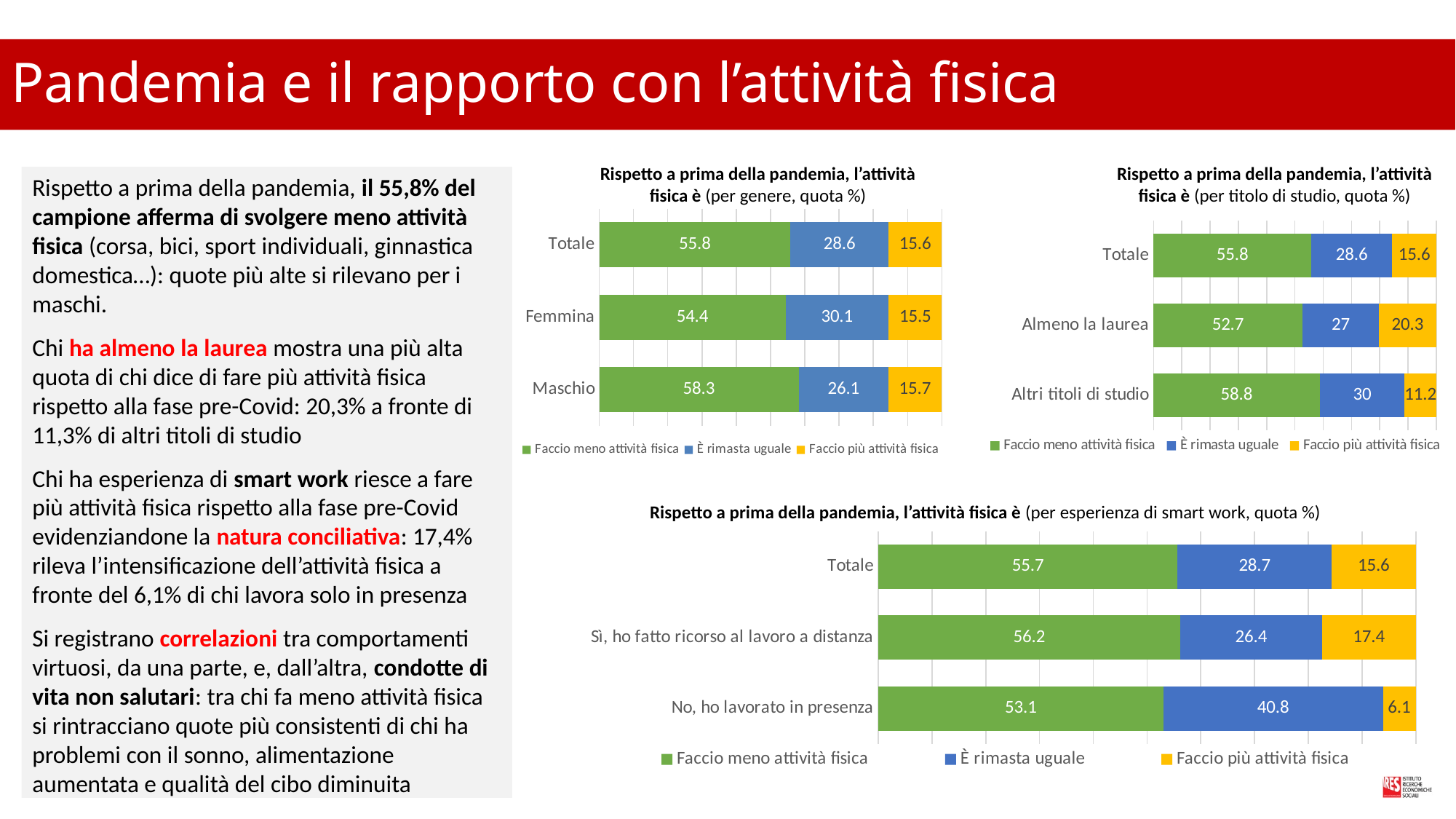
In the chart by education level (per titolo di studio), is the 'Faccio meno attività fisica' value larger for Almeno la laurea or for Altri titoli di studio? Altri titoli di studio In the chart by gender (per genere), what is the value of 'Faccio meno attività fisica' for Maschio? 58.3 In the chart by smart work experience, how many series does the legend list? 3 What type of chart is the chart by gender (per genere)? Stacked bar chart In the chart by smart work experience, what is the difference between the 'Faccio più attività fisica' values for 'Sì, ho fatto ricorso al lavoro a distanza' and 'No, ho lavorato in presenza'? 11.3 In the chart by gender (per genere), what is the difference between the 'Faccio meno attività fisica' values for Maschio and Femmina? 3.9 In the chart by smart work experience, how many categories are shown on the vertical axis? 3 In the chart by smart work experience, what is the value of 'È rimasta uguale' for 'No, ho lavorato in presenza'? 40.8 In the chart by education level (per titolo di studio), which category has the lowest value for 'Faccio più attività fisica'? Altri titoli di studio In the chart by gender (per genere), what is the value of 'È rimasta uguale' for Femmina? 30.1 In the chart by gender (per genere), which category has the highest value for 'Faccio meno attività fisica'? Maschio In the chart by education level (per titolo di studio), what is the value of 'Faccio più attività fisica' for Almeno la laurea? 20.3